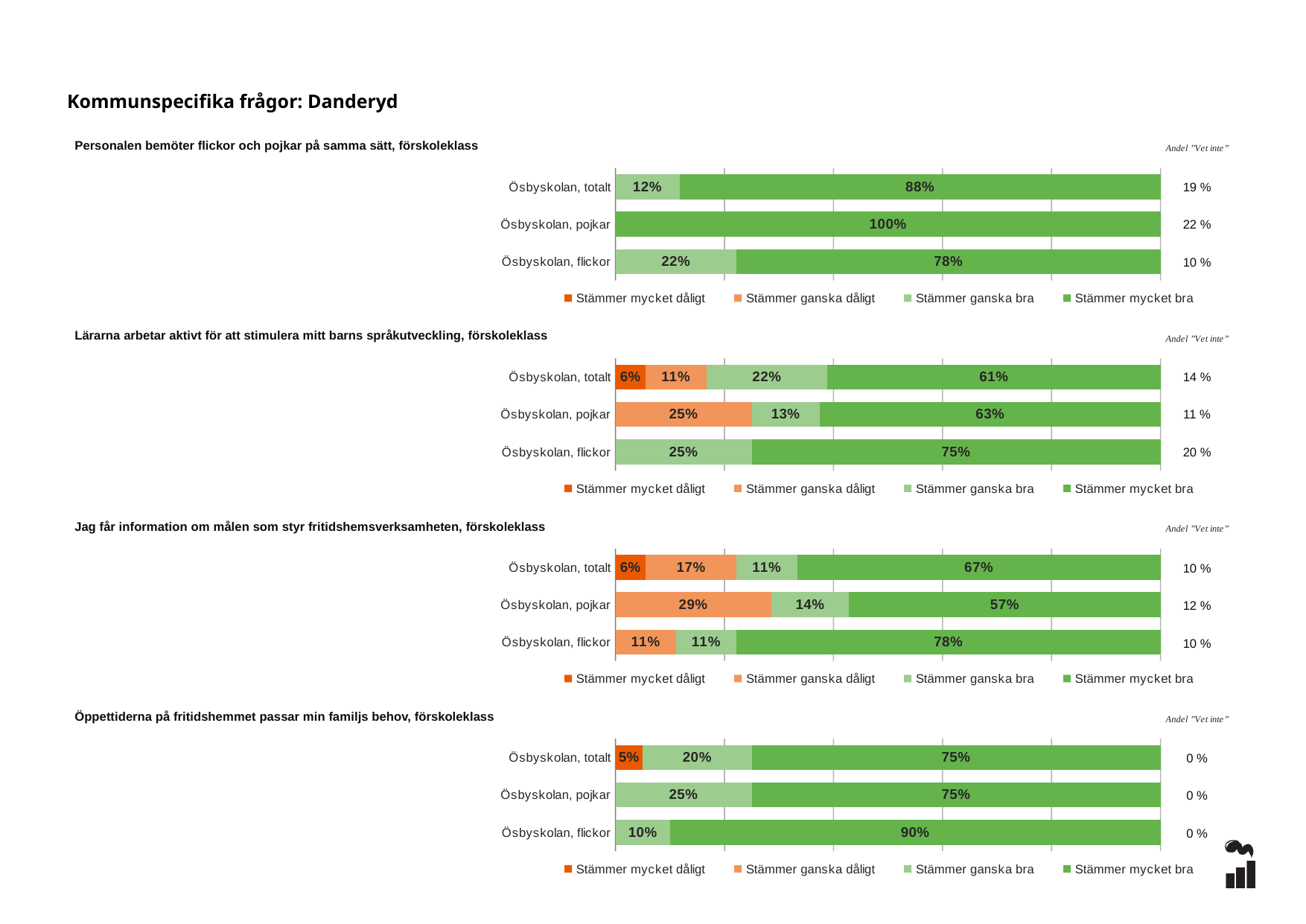
How many rows (categories) are shown in the chart 'Öppettiderna på fritidshemmet passar min familjs behov, förskoleklass'? 3 In the chart 'Lärarna arbetar aktivt för att stimulera mitt barns språkutveckling, förskoleklass', what is the 'Stämmer mycket bra' value for Ösbyskolan, totalt? 61% In the chart 'Personalen bemöter flickor och pojkar på samma sätt, förskoleklass', what is the 'Andel Vet inte' value for Ösbyskolan, pojkar? 22 % In the chart 'Öppettiderna på fritidshemmet passar min familjs behov, förskoleklass', what is the 'Stämmer mycket bra' value for Ösbyskolan, flickor? 90% In the chart 'Lärarna arbetar aktivt för att stimulera mitt barns språkutveckling, förskoleklass', which row has the highest 'Stämmer mycket bra' value? Ösbyskolan, flickor In the chart 'Personalen bemöter flickor och pojkar på samma sätt, förskoleklass', what is the 'Stämmer ganska bra' value for Ösbyskolan, flickor? 22% What kind of chart is 'Jag får information om målen som styr fritidshemsverksamheten, förskoleklass'? Stacked horizontal bar chart In the chart 'Öppettiderna på fritidshemmet passar min familjs behov, förskoleklass', which row has the lowest 'Stämmer mycket bra' value? Ösbyskolan, totalt and Ösbyskolan, pojkar (both 75%) In the chart 'Personalen bemöter flickor och pojkar på samma sätt, förskoleklass', what is the 'Stämmer mycket bra' value for Ösbyskolan, pojkar? 100% How many series does the legend list for the chart 'Lärarna arbetar aktivt för att stimulera mitt barns språkutveckling, förskoleklass'? 4 In the chart 'Jag får information om målen som styr fritidshemsverksamheten, förskoleklass', what is the 'Stämmer ganska dåligt' value for Ösbyskolan, pojkar? 29% In the chart 'Jag får information om målen som styr fritidshemsverksamheten, förskoleklass', what is the difference between the 'Stämmer mycket bra' values for Ösbyskolan, flickor and Ösbyskolan, pojkar? 21%